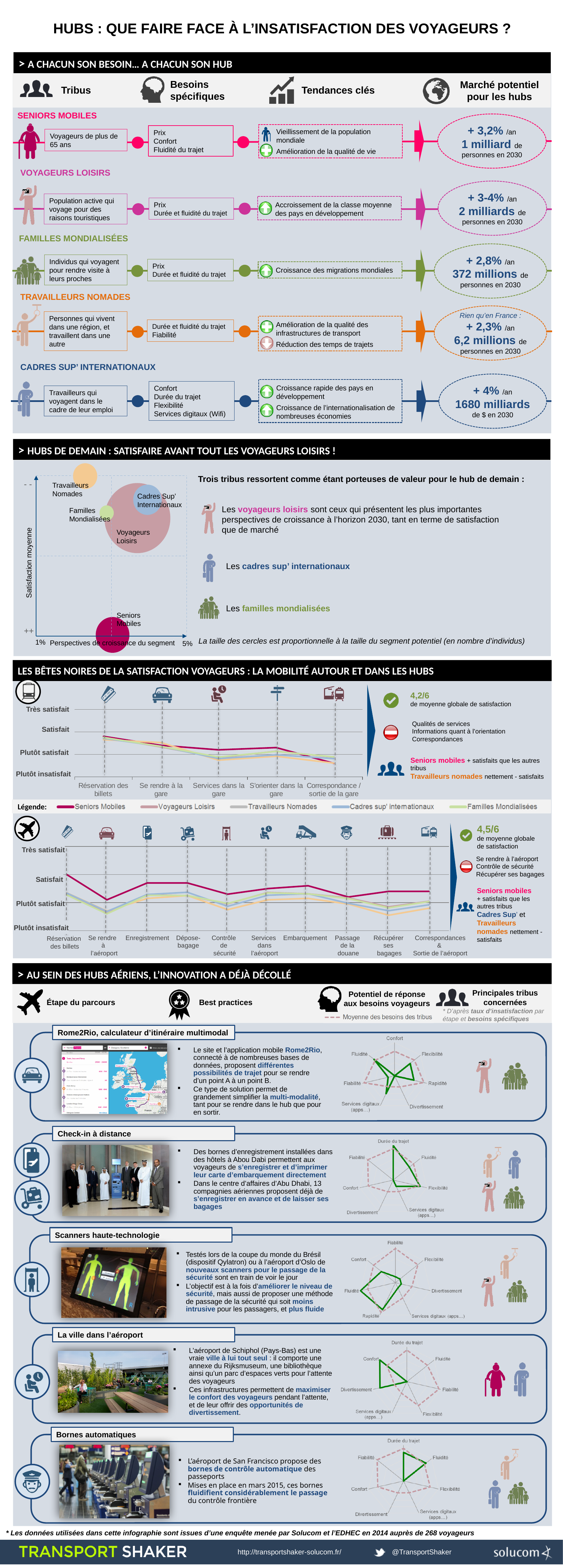
In the airport (aéroport) satisfaction line chart, how many journey stages are shown on the x axis? 10 In the 'Hubs de demain' bubble chart, what is the label of the x axis? Perspectives de croissance du segment What is the overall average satisfaction score shown next to the airport (aéroport) line chart? 4,5/6 In the airport (aéroport) satisfaction line chart, which series has the highest satisfaction at 'Réservation des billets'? Seniors Mobiles In the train (gare) satisfaction line chart, do the satisfaction lines rise or fall from 'Réservation des billets' to 'Correspondance / sortie de la gare'? Fall What kind of chart is used in the 'Hubs de demain' section to plot the tribes against growth prospects and average satisfaction? Bubble chart What is the overall average satisfaction score shown next to the train (gare) line chart? 4,2/6 In the 'Hubs de demain' bubble chart, how many tribes (bubbles) are plotted? 5 In the train (gare) satisfaction line chart, how many journey stages are shown on the x axis? 5 In the train (gare) satisfaction line chart, which series has the highest satisfaction at 'Réservation des billets'? Seniors Mobiles In the train (gare) satisfaction line chart, how many series does the legend list? 5 In the 'Hubs de demain' bubble chart, which tribe has the largest bubble? Voyageurs Loisirs